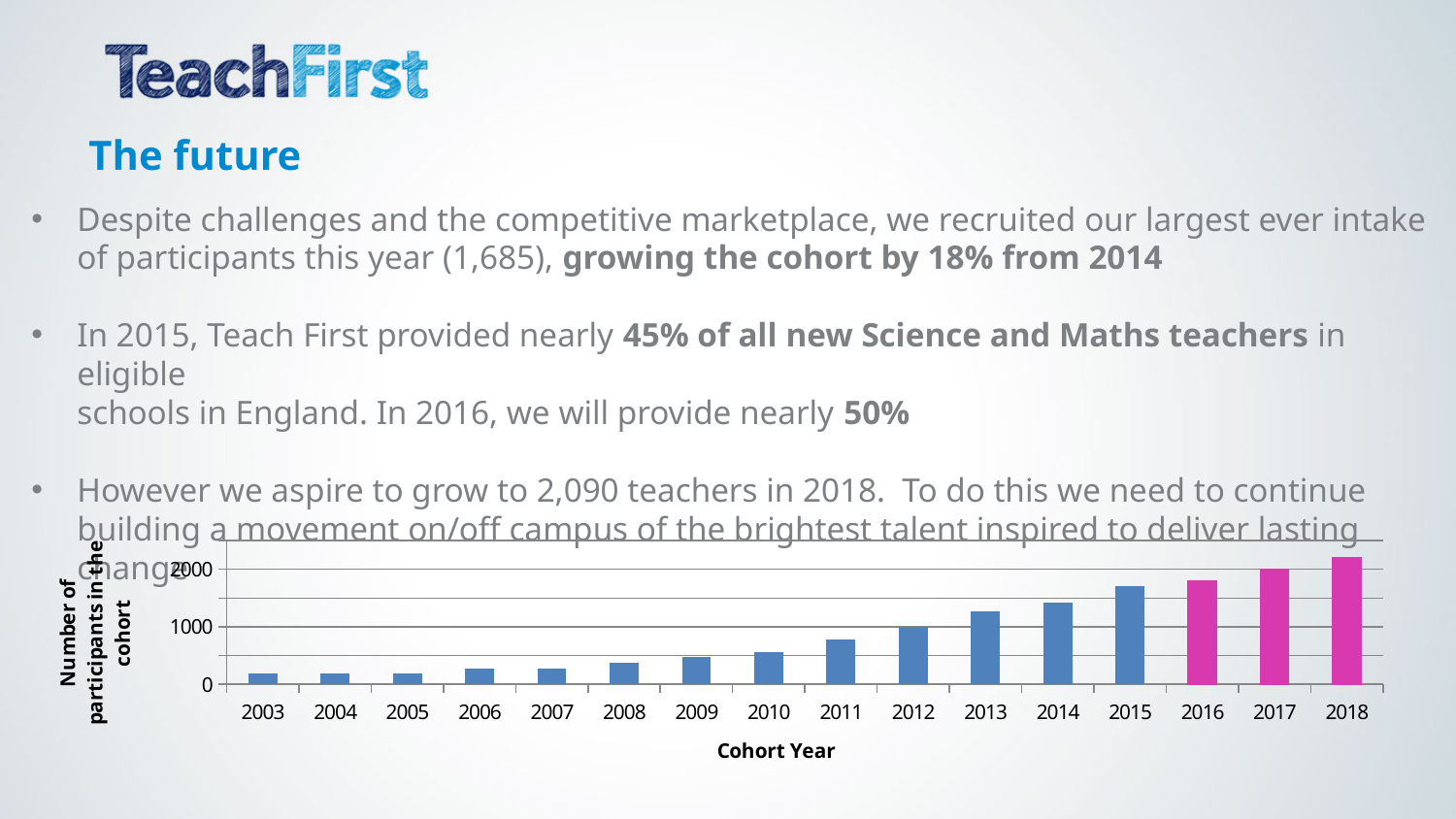
Is the value for 2003 greater or less than 1000? less Which has the larger value, 2010 or 2015? 2015 Do the bar values generally rise or fall from 2003 to 2018? rise How many cohort years are plotted on the x axis of the chart? 16 Which cohort year has the highest bar in the chart? 2018 What is the title of the x axis of the chart? Cohort Year Is the value for 2016 greater or less than 2000? less Is the value for 2013 greater or less than 1000? greater What kind of chart is shown on the slide? bar chart Which cohort years are shown with pink bars instead of blue? 2016, 2017 and 2018